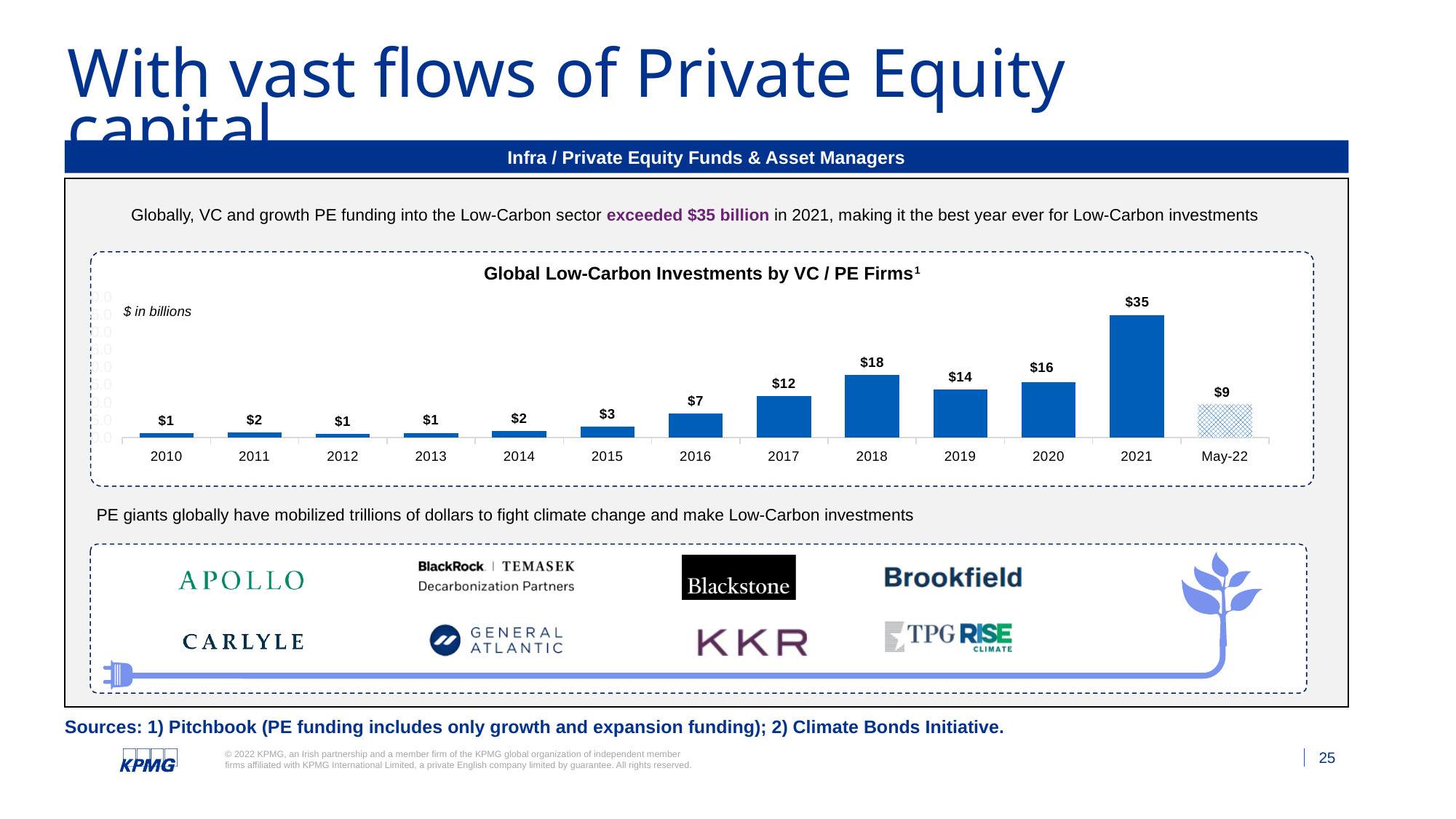
What is the difference between the 2021 and 2020 values in the Global Low-Carbon Investments by VC / PE Firms chart? $19 What is the value for 2021 in the Global Low-Carbon Investments by VC / PE Firms chart? $35 What is the difference between the 2018 and 2019 values in the Global Low-Carbon Investments by VC / PE Firms chart? $4 Which is larger in the Global Low-Carbon Investments by VC / PE Firms chart, the value for 2019 or the value for 2020? 2020 What is the value for 2018 in the Global Low-Carbon Investments by VC / PE Firms chart? $18 How many categories are shown on the x axis of the Global Low-Carbon Investments by VC / PE Firms chart? 13 What kind of chart is the Global Low-Carbon Investments by VC / PE Firms chart? Bar chart Do the values in the Global Low-Carbon Investments by VC / PE Firms chart generally rise or fall from 2013 to 2018? Rise What is the value for May-22 in the Global Low-Carbon Investments by VC / PE Firms chart? $9 What is the value for 2016 in the Global Low-Carbon Investments by VC / PE Firms chart? $7 What unit is stated for the values in the Global Low-Carbon Investments by VC / PE Firms chart? $ in billions Which year has the highest value in the Global Low-Carbon Investments by VC / PE Firms chart? 2021